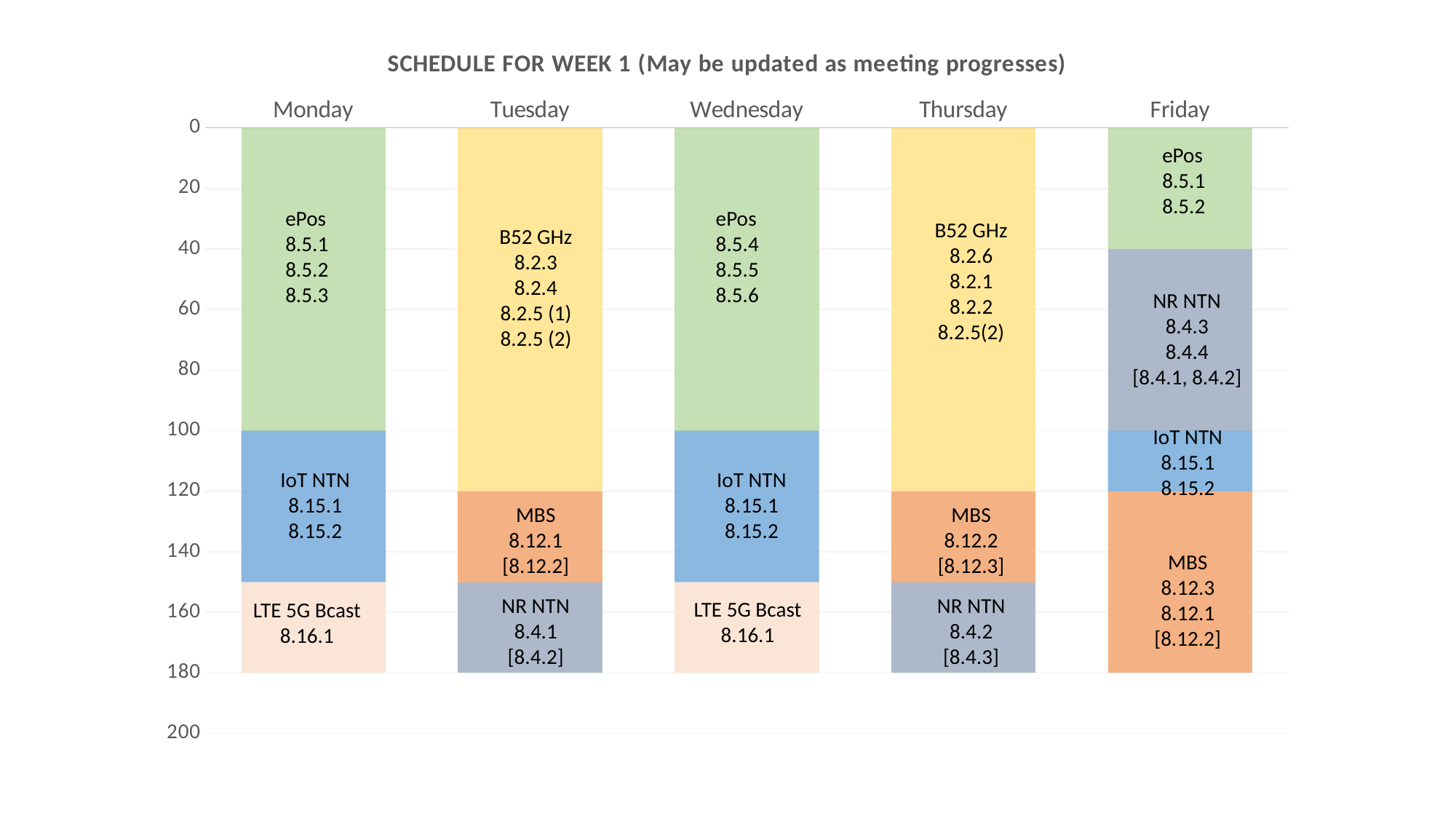
How many segments make up the Friday bar? 4 At what axis value does the Monday bar end in total? 180 How large is the ePos segment of the Friday bar, according to the axis? 40 How large is the ePos segment of the Monday bar, according to the axis? 100 What is the title of the chart? SCHEDULE FOR WEEK 1 (May be updated as meeting progresses) Which topic occupies the top segment of the Tuesday bar? B52 GHz Is the B52 GHz segment on Tuesday greater or less than 100? greater How large is the MBS segment of the Friday bar, according to the axis? 60 On Friday, which segment is larger: NR NTN or IoT NTN? NR NTN Which is larger: the ePos segment on Monday or the ePos segment on Friday? Monday What kind of chart is shown on the slide? bar chart How many days (categories) are shown along the x axis? 5